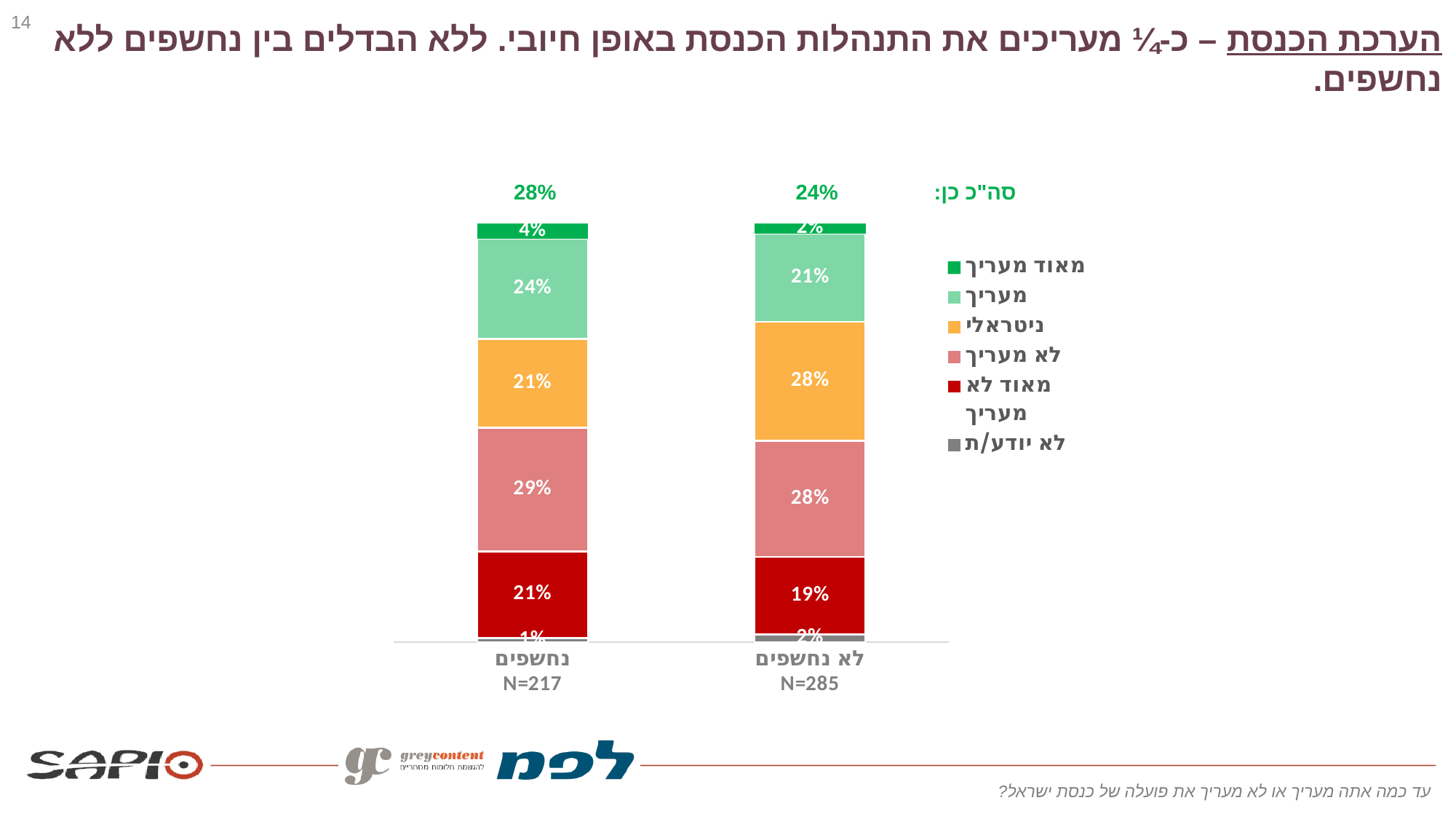
How many bars (categories) are plotted on the chart? 2 Which bar has the larger לא מעריך segment, נחשפים or לא נחשפים? נחשפים What kind of chart is shown on the slide? Stacked bar chart What is the difference between the סה"כ כן values of נחשפים and לא נחשפים? 4% What is the סה"כ כן (total positive) value shown above the נחשפים bar? 28% How many series does the legend list? 6 What sample size (N) is shown for the לא נחשפים category? N=285 What is the difference between the ניטראלי values of לא נחשפים and נחשפים? 7% What is the value of the מאוד לא מעריך segment for the לא נחשפים bar? 19% What is the value of the ניטראלי segment for the לא נחשפים bar? 28% What is the value of the מעריך segment for the נחשפים bar? 24% What is the value of the מאוד מעריך segment for the נחשפים bar? 4%